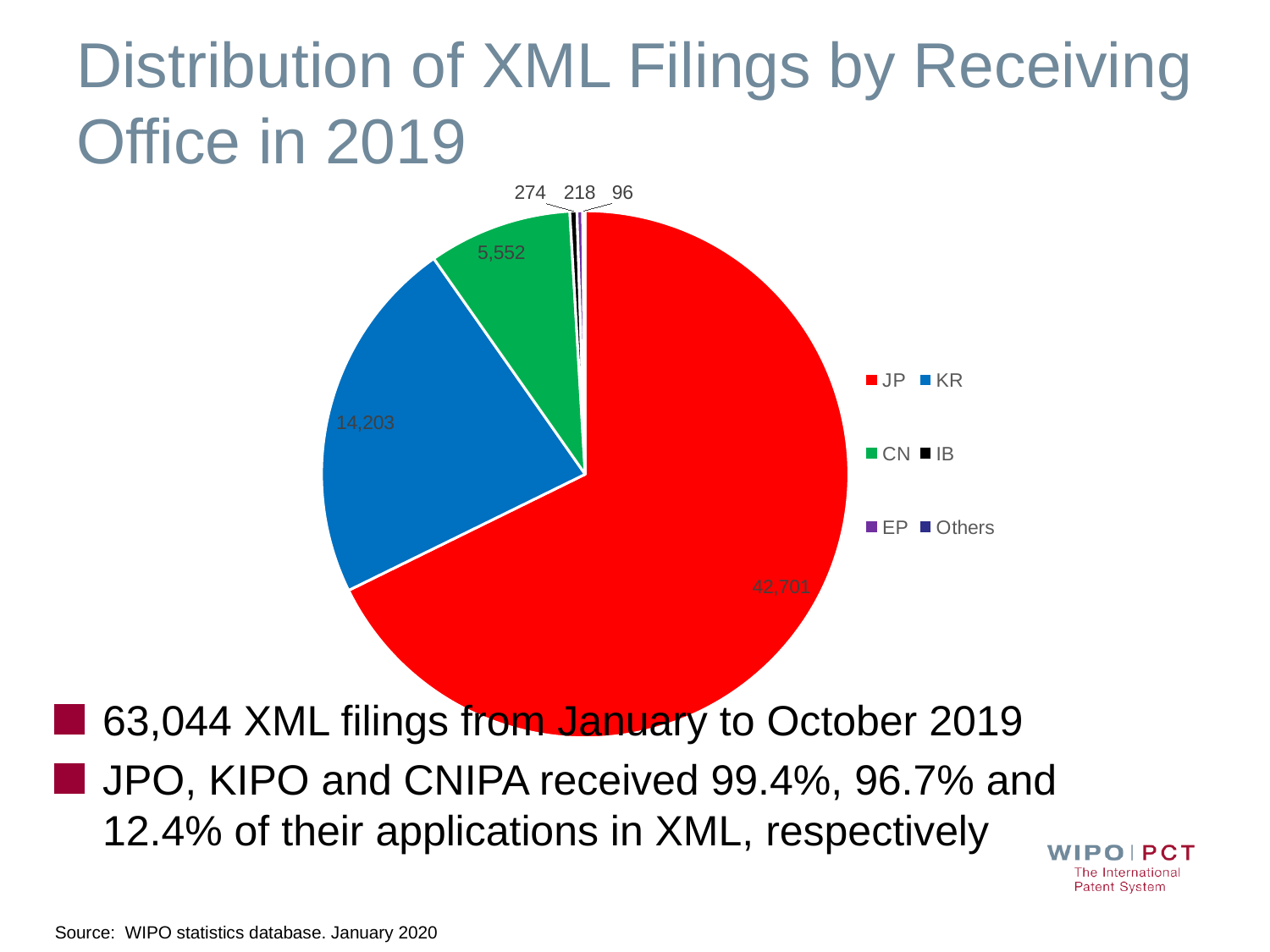
What type of chart is shown on the slide? pie chart What is the value for Others in the pie chart? 96 What is the title of the chart on the slide? Distribution of XML Filings by Receiving Office in 2019 What is the value for CN in the pie chart? 5,552 What is the difference between the values for JP and KR? 28,498 What is the value for KR in the pie chart? 14,203 Which is larger, the value for KR or the value for CN? KR How many categories does the legend of the pie chart list? 6 Which receiving office has the largest slice of the pie? JP What is the value for JP in the pie chart? 42,701 Which category has the smallest slice of the pie? Others What is the value for IB in the pie chart? 274